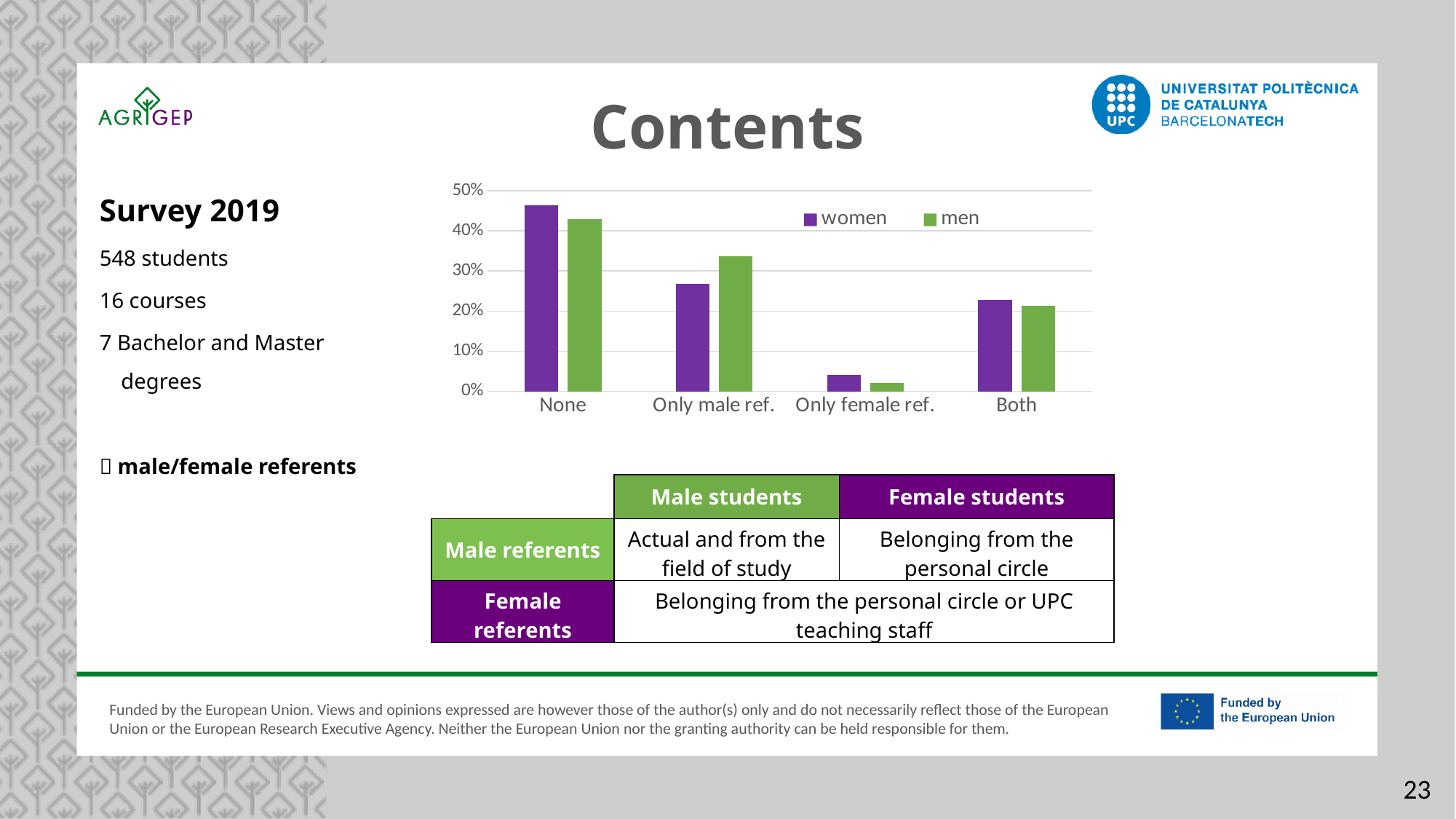
Which category has the lowest value for men? Only female ref. Is the value for men in the Only male ref. category greater or less than 30%? greater What kind of chart is shown on the slide? bar chart Is the value for men in the Both category greater or less than 30%? less How many categories are shown on the x axis of the chart? 4 How many series does the chart legend list? 2 Which category has the highest value for women? None For the category None, which is larger, the value for women or the value for men? women Is the value for women in the Only female ref. category greater or less than 10%? less Which colour represents the women series in the chart? purple For the category Only male ref., which is larger, the value for women or the value for men? men